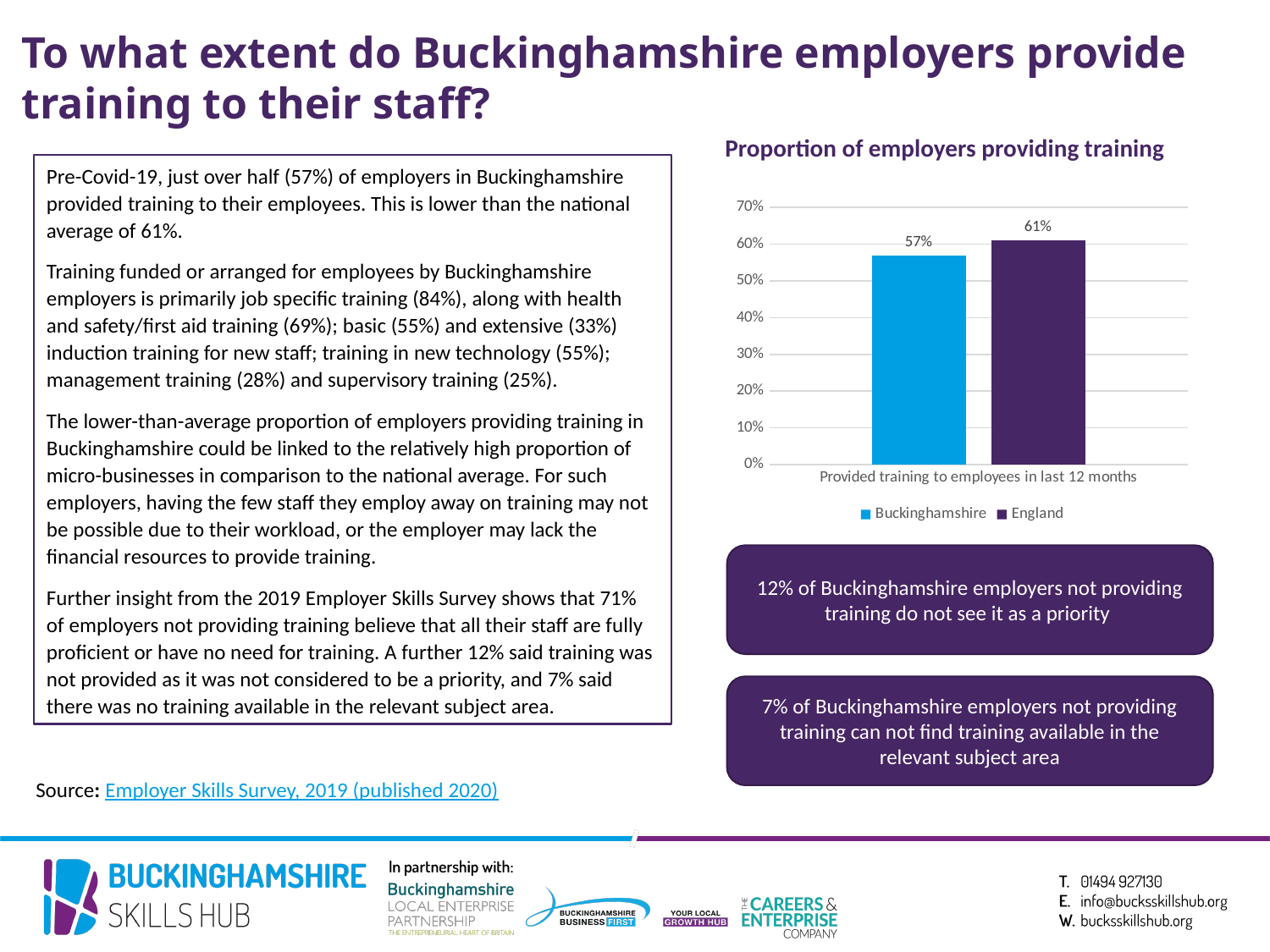
What is the difference between the England and Buckinghamshire values? 4% Is the value for Buckinghamshire greater or less than 60%? less What is the value for England in the chart? 61% How many series does the legend list? 2 Which series has the lowest value in the chart? Buckinghamshire What is the value for Buckinghamshire in the chart? 57% Which series has the higher value, Buckinghamshire or England? England What is the title of the chart? Proportion of employers providing training What is the category label on the x axis of the chart? Provided training to employees in last 12 months Is the value for England greater or less than 60%? greater What kind of chart is shown on the slide? Bar chart How many categories are shown on the x axis of the chart? 1